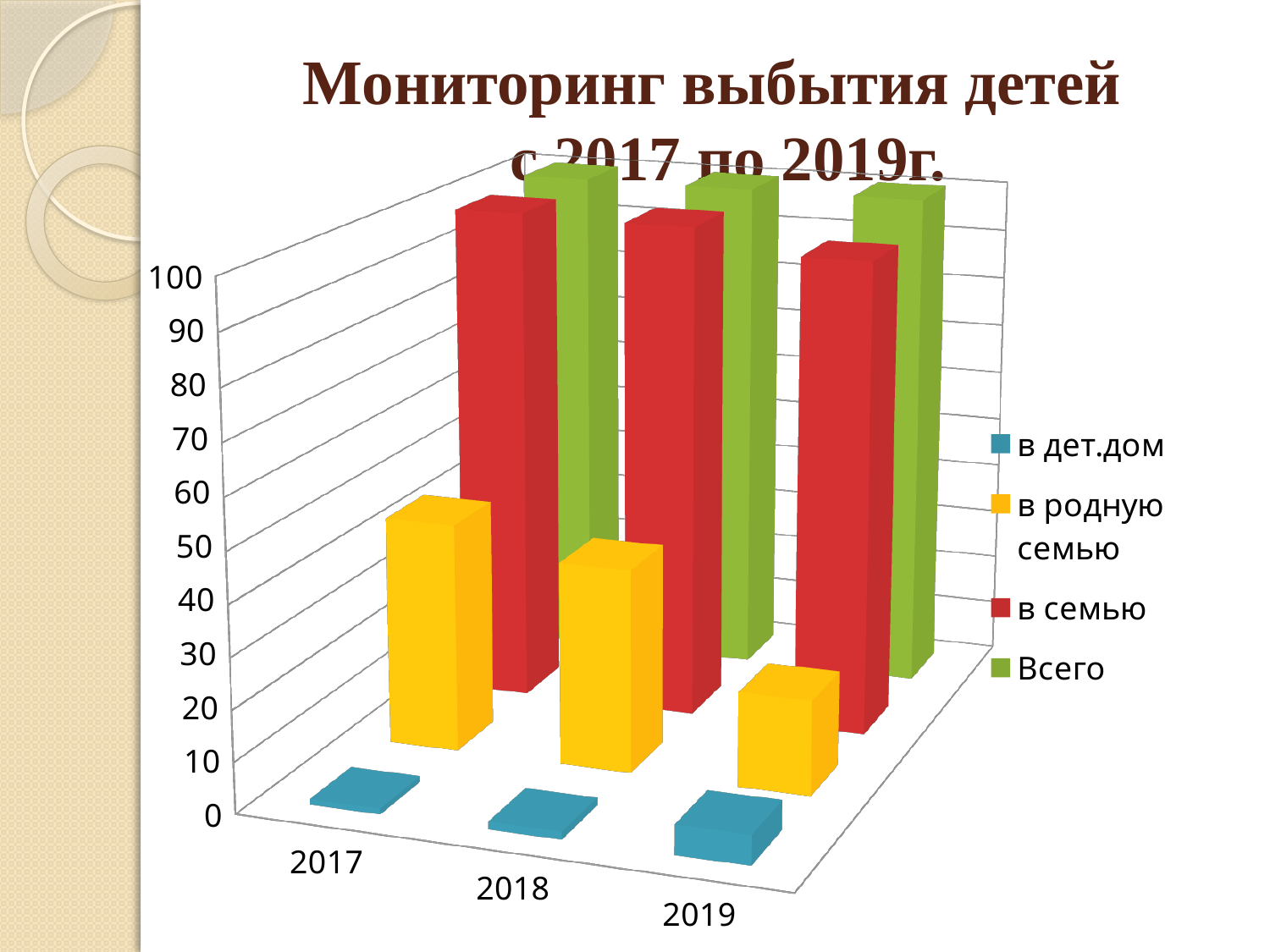
Which series is shown in green in the legend? Всего Which series has the lowest value in 2019? в дет.дом Which is larger: the value for "в родную семью" in 2017 or in 2019? 2017 What is the title of the chart? Мониторинг выбытия детей с 2017 по 2019г. How many years are shown on the x axis? 3 What kind of chart is shown on the slide? bar chart In which year is the value for "в родную семью" lowest? 2019 In which year is the value for "в родную семью" highest? 2017 Is the value for "в дет.дом" in 2018 greater or less than 10? less Do the values for "в семью" rise or fall from 2017 to 2019? fall How many series does the legend list? 4 Is the value for "в дет.дом" in 2017 greater or less than 10? less